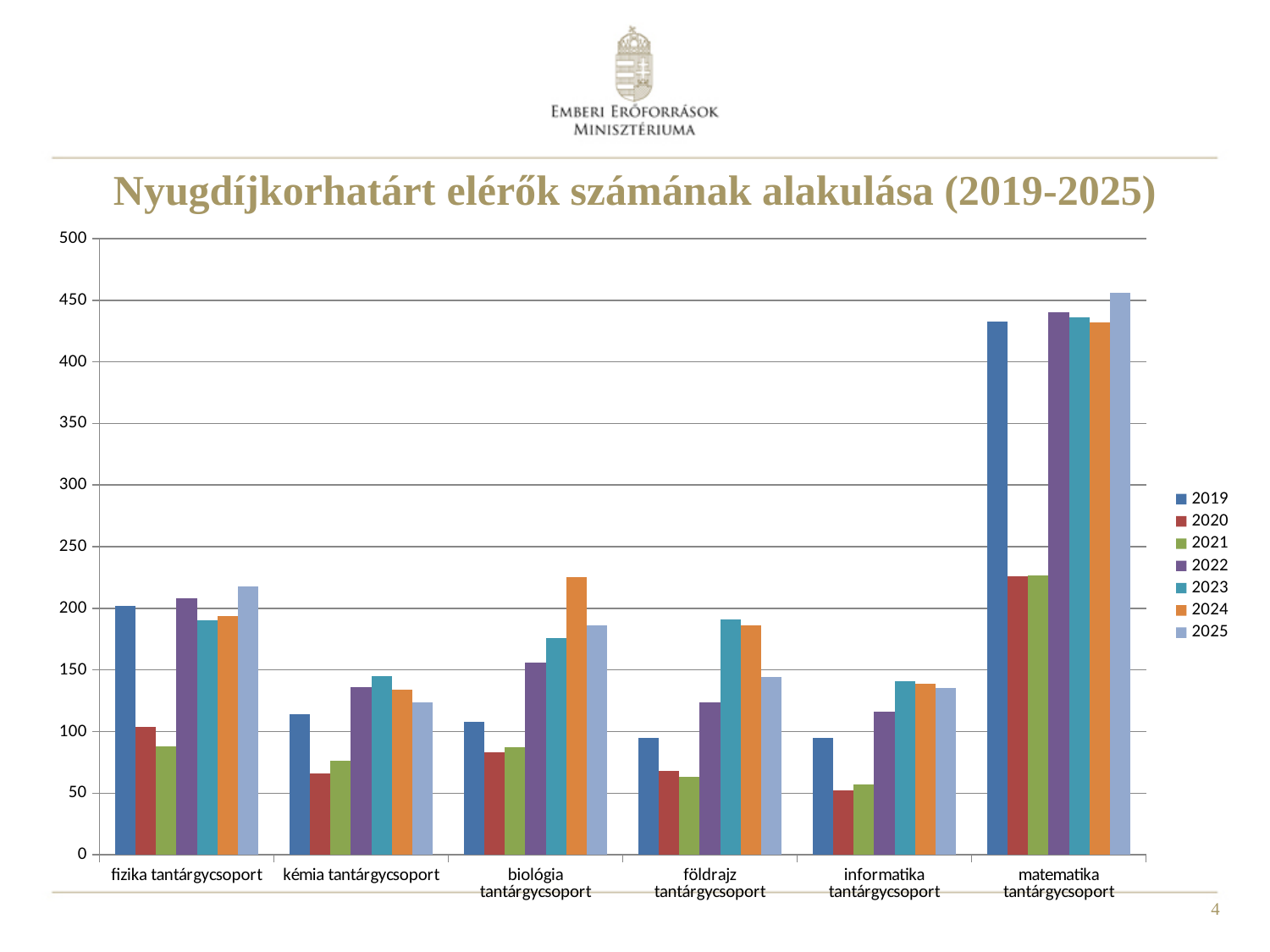
Within matematika tantárgycsoport, which year has the highest value? 2025 For földrajz tantárgycsoport, which is larger, the 2022 value or the 2023 value? 2023 Is the 2024 value for biológia tantárgycsoport greater or less than 200? greater Which is larger, the 2019 value for fizika tantárgycsoport or the 2019 value for kémia tantárgycsoport? fizika tantárgycsoport Which subject group has the lowest value for 2020? informatika tantárgycsoport How many subject groups (categories) are shown on the x axis? 6 How many series does the legend list? 7 Which subject group has the highest value for 2025? matematika tantárgycsoport What is the title of the chart? Nyugdíjkorhatárt elérők számának alakulása (2019-2025) Is the 2019 value for matematika tantárgycsoport greater or less than 400? greater Is the 2020 value for informatika tantárgycsoport greater or less than 100? less What kind of chart is shown on the slide? bar chart